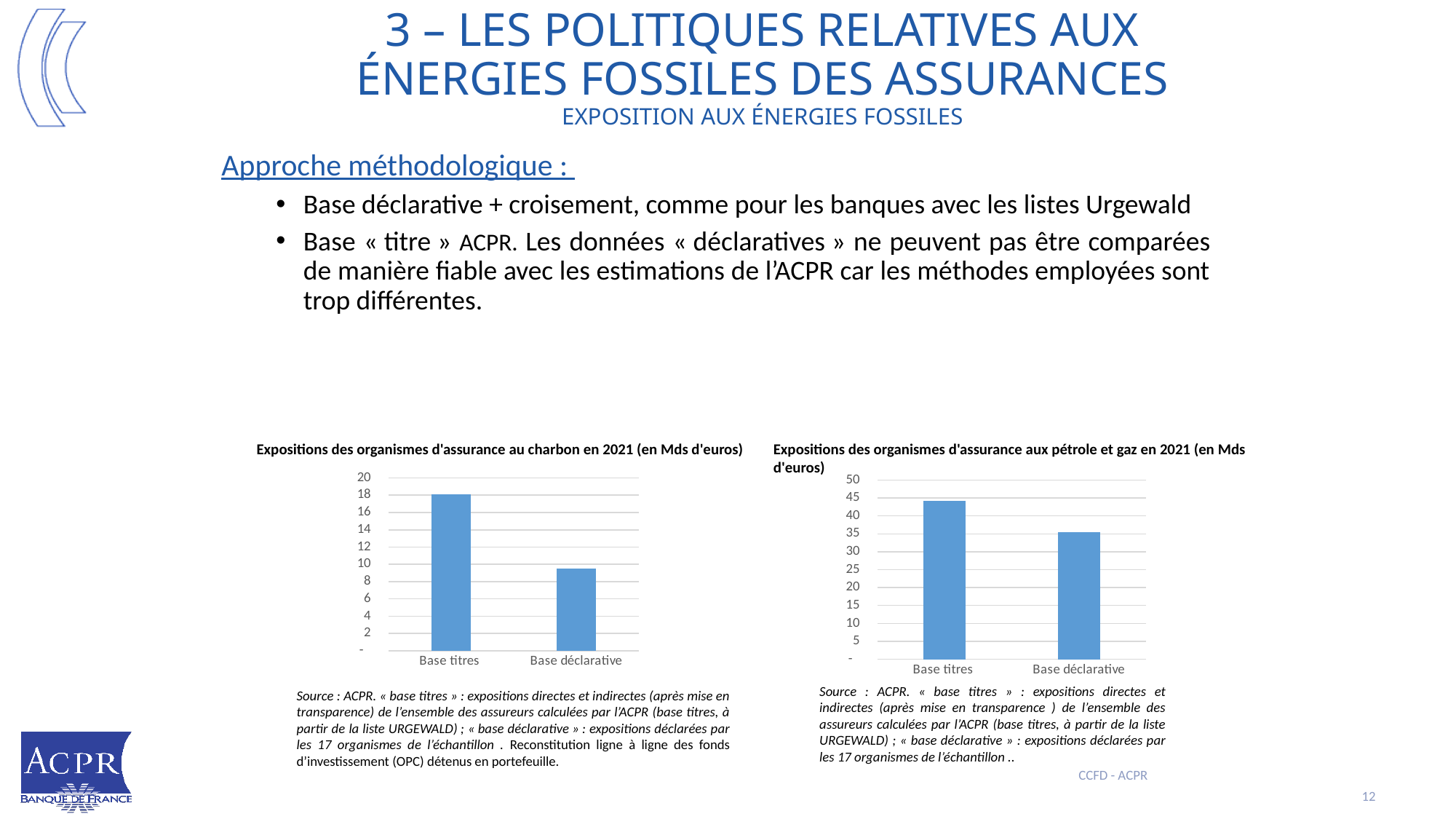
In the chart 'Expositions des organismes d'assurance aux pétrole et gaz en 2021', what is the highest value shown on the vertical axis? 50 In the chart 'Expositions des organismes d'assurance au charbon en 2021', is the value for Base titres greater or less than 16? greater In the chart 'Expositions des organismes d'assurance aux pétrole et gaz en 2021', which category has the lower value? Base déclarative In what unit are the values of the chart 'Expositions des organismes d'assurance au charbon en 2021' expressed, according to its title? Mds d'euros In the chart 'Expositions des organismes d'assurance au charbon en 2021', is the value for Base titres larger or smaller than the value for Base déclarative? larger In the chart 'Expositions des organismes d'assurance au charbon en 2021', how many categories are shown on the x axis? 2 In the chart 'Expositions des organismes d'assurance au charbon en 2021', which category has the higher value? Base titres In the chart 'Expositions des organismes d'assurance aux pétrole et gaz en 2021', is the value for Base déclarative greater or less than 30? greater What type of chart is 'Expositions des organismes d'assurance au charbon en 2021'? bar chart In the chart 'Expositions des organismes d'assurance aux pétrole et gaz en 2021', is the value for Base titres greater or less than 40? greater